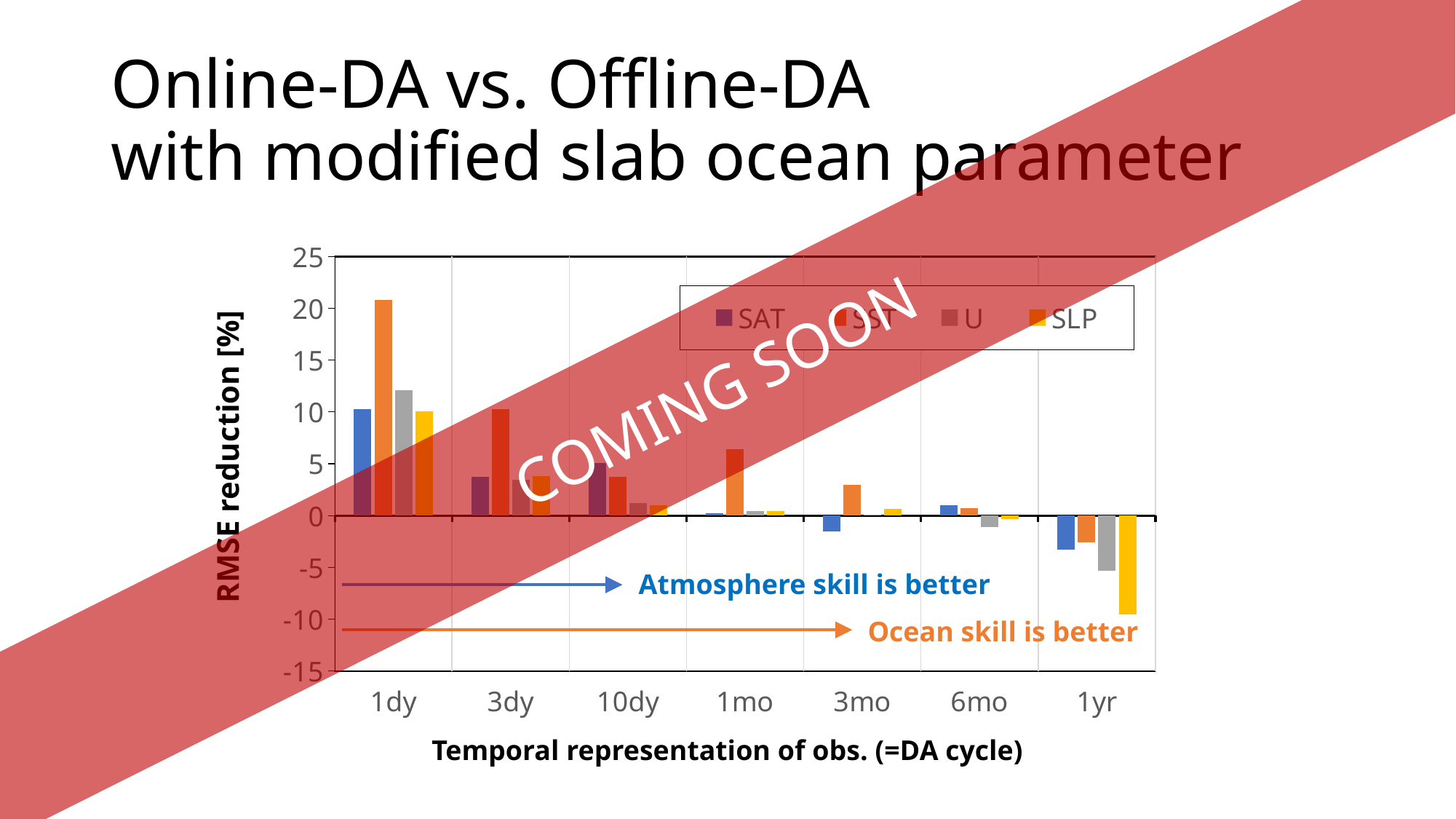
Which series has the highest RMSE reduction at 1dy? SST Which series has the lowest value at 1yr? SLP Is the SST value at 3mo greater or less than 5? less Do the SST values generally rise or fall from 1dy to 1yr along the x axis? fall What kind of chart is shown on the slide? bar chart How many categories are shown on the x axis? 7 Is the SLP value at 1yr greater or less than -5? less At 1dy, which is larger: the SAT value or the SST value? SST How many series does the legend list? 4 Is the SAT value at 1dy greater or less than 5? greater What is the label of the y axis? RMSE reduction [%]